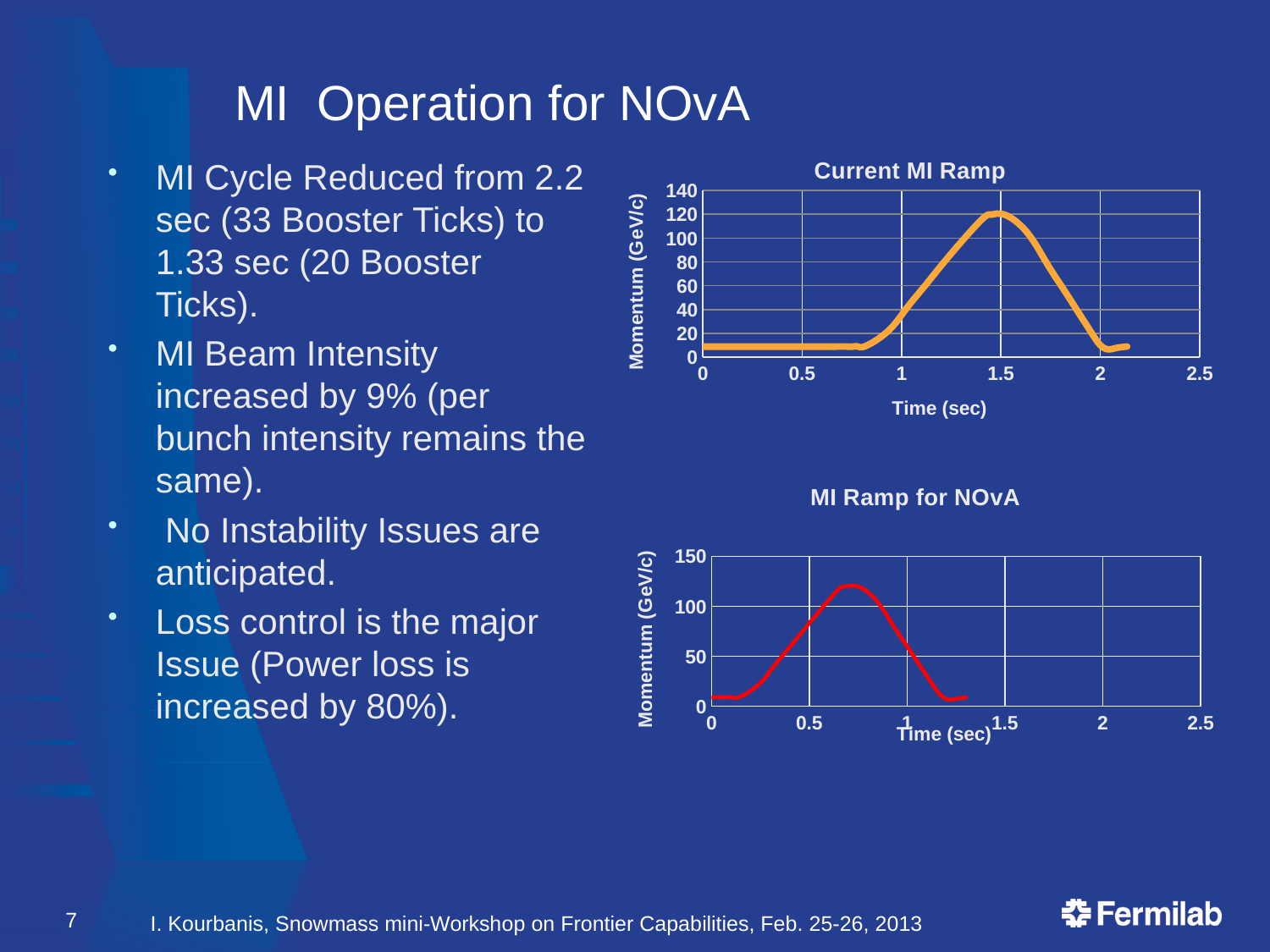
In the 'Current MI Ramp' chart, is the peak momentum greater or less than 100? greater In the 'Current MI Ramp' chart, is the peak momentum greater or less than 140? less What is the y-axis label of the 'Current MI Ramp' chart? Momentum (GeV/c) In the 'Current MI Ramp' chart, does the momentum rise or fall between 1 sec and 1.5 sec? rise What is the highest value shown on the x axis of the 'MI Ramp for NOvA' chart? 2.5 In the 'Current MI Ramp' chart, is the momentum at time 0.5 sec greater or less than 20? less In the 'MI Ramp for NOvA' chart, does the momentum rise or fall between 1 sec and 1.5 sec? fall What kind of chart is the 'Current MI Ramp' chart? line chart What kind of chart is the 'MI Ramp for NOvA' chart? line chart